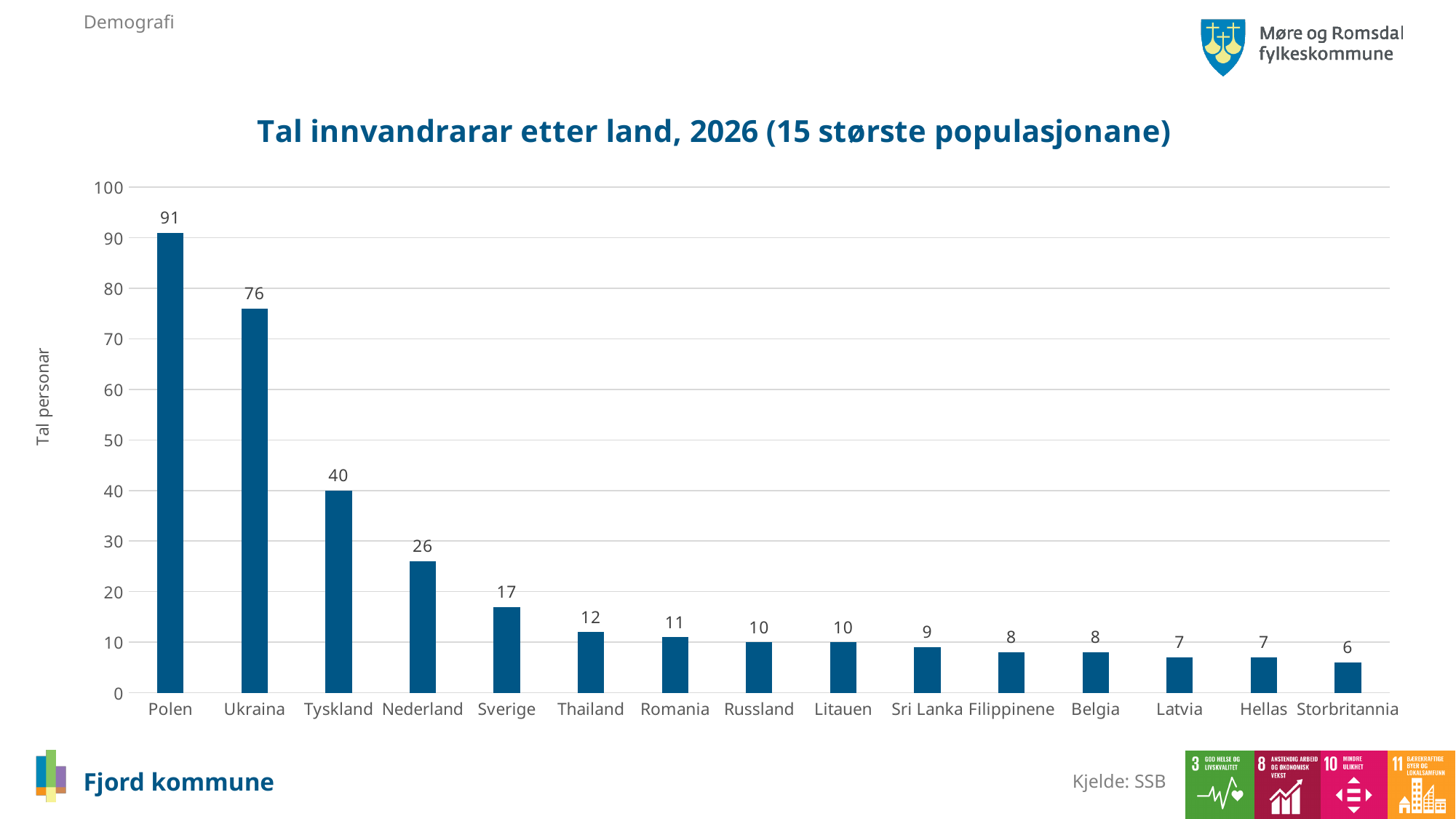
What is the value for Sri Lanka? 9 Is the value for Ukraina greater or less than 70? greater What is the value for Polen? 91 What is the title of the chart? Tal innvandrarar etter land, 2026 (15 største populasjonane) Which country has the highest value? Polen What is the value for Nederland? 26 Which is larger, the value for Thailand or the value for Romania? Thailand What is the difference between the values for Tyskland and Sverige? 23 Which country has the lowest value? Storbritannia How many countries are shown on the x axis? 15 What kind of chart is shown on the slide? bar chart What is the difference between the values for Polen and Ukraina? 15